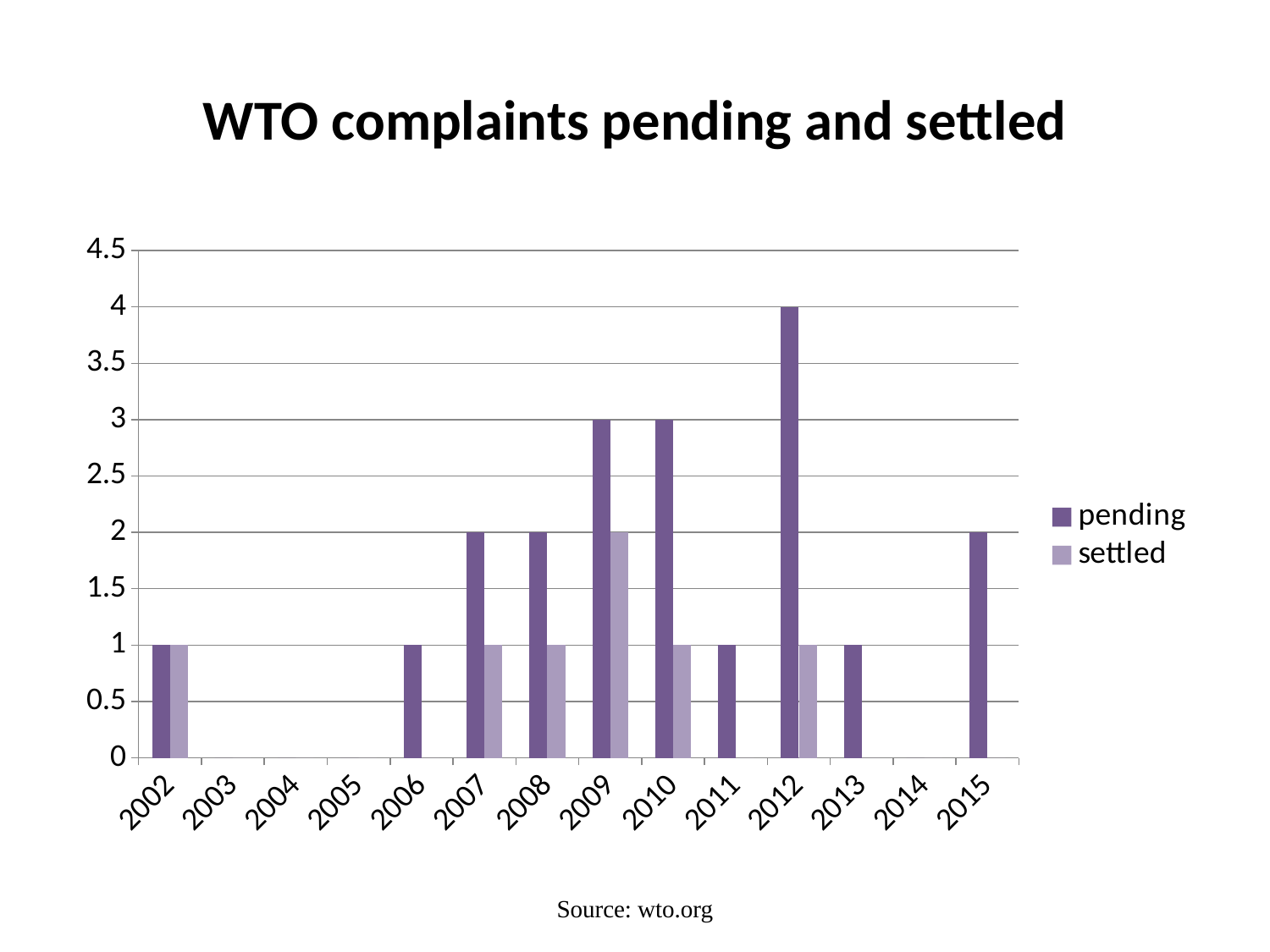
What is the value for pending complaints in 2012? 4 Which is larger, pending complaints in 2009 or pending complaints in 2015? pending complaints in 2009 How many series does the legend list? 2 Which year has the highest number of settled complaints? 2009 What is the title of the chart? WTO complaints pending and settled What is the value for pending complaints in 2015? 2 Is the value for pending complaints in 2012 greater or less than 3.5? greater What is the difference between pending and settled complaints in 2012? 3 How many years are shown on the x axis? 14 Which year has the highest number of pending complaints? 2012 What is the value for settled complaints in 2009? 2 What kind of chart is shown on the slide? bar chart